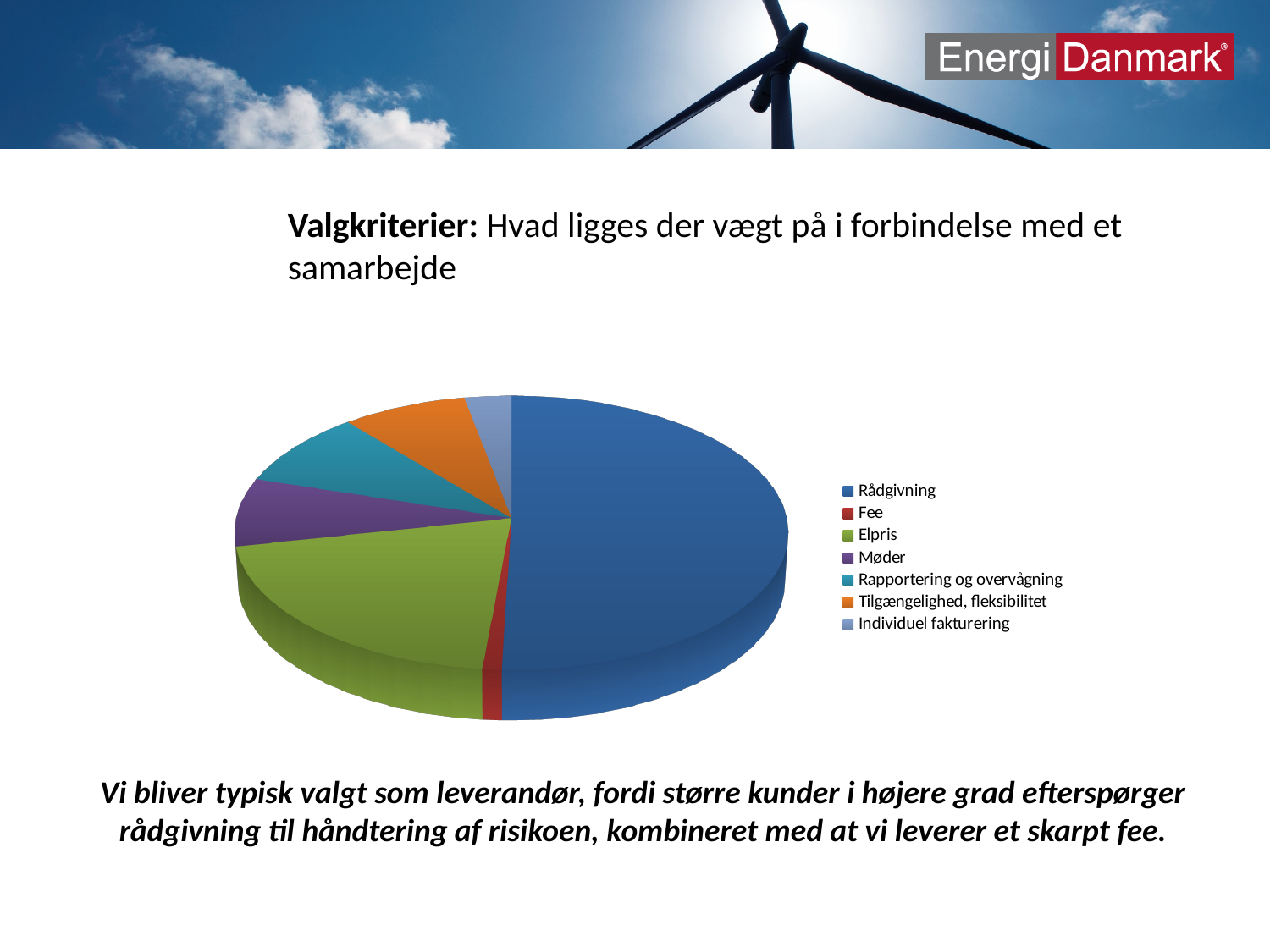
Which category has the largest slice of the pie chart? Rådgivning Which slice is larger, Elpris or Møder? Elpris Which slice is larger, Elpris or Individuel fakturering? Elpris Which slice is larger, Rapportering og overvågning or Fee? Rapportering og overvågning What colour is the Elpris slice in the pie chart? Green Which category is shown in orange in the pie chart's legend? Tilgængelighed, fleksibilitet What kind of chart is shown on the slide? Pie chart Which category has the smallest slice of the pie chart? Fee How many categories does the pie chart's legend list? 7 Which category is the second-largest slice of the pie chart? Elpris